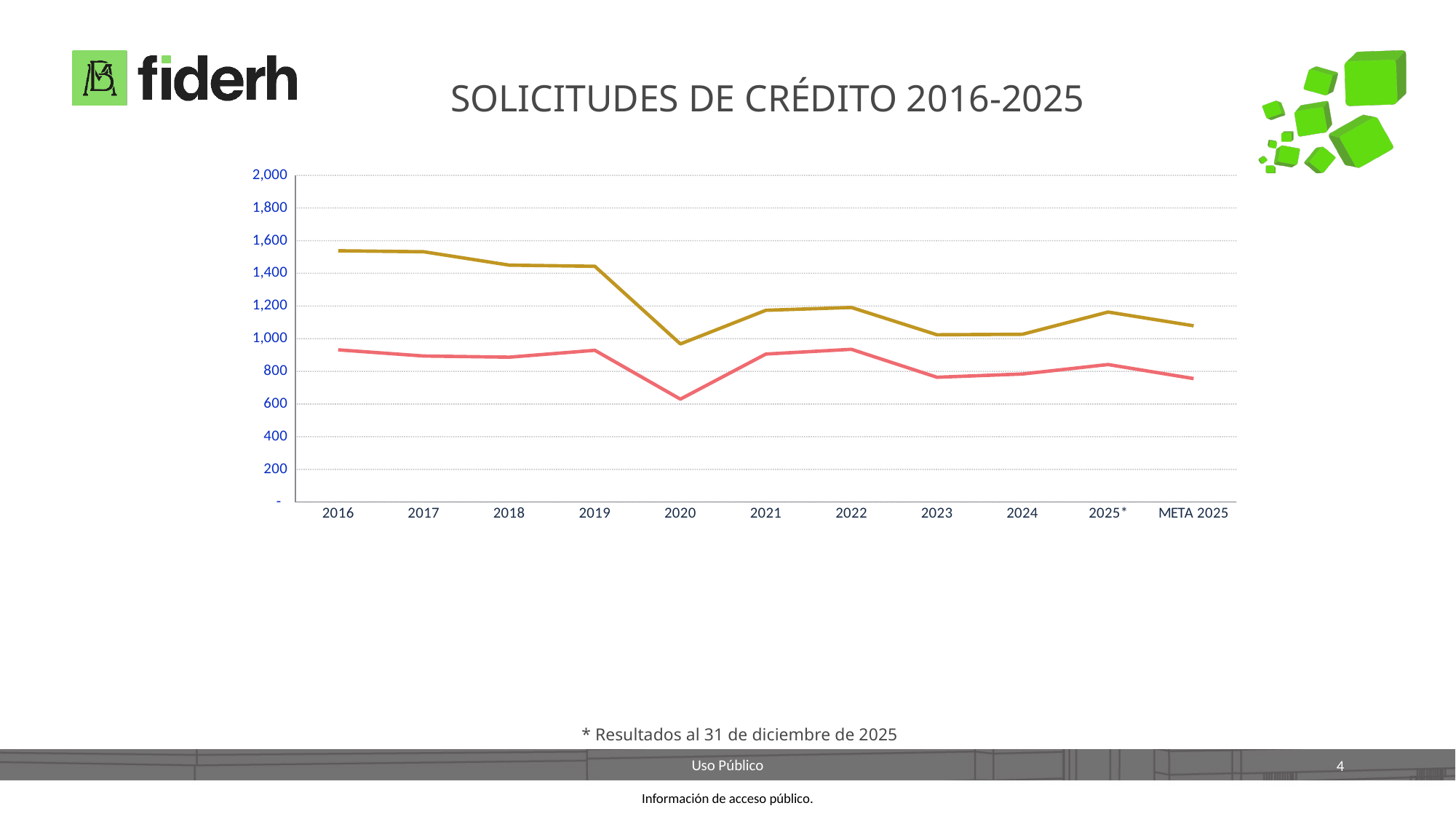
Is the value of the pink line for 2020 greater or less than 800? less How many lines are plotted on the chart? 2 For 2020, which line has the larger value, the gold line or the pink line? gold line What is the title of the chart? SOLICITUDES DE CRÉDITO 2016-2025 In which year does the pink line reach its lowest value? 2020 In which year does the gold line reach its lowest value? 2020 Does the gold line rise or fall from 2016 to 2020? fall How many categories are shown on the x axis of the chart? 11 Is the value of the gold line for 2022 greater or less than 1,000? greater Is the value of the pink line for 2016 greater or less than 800? greater What kind of chart is shown on the slide? line chart